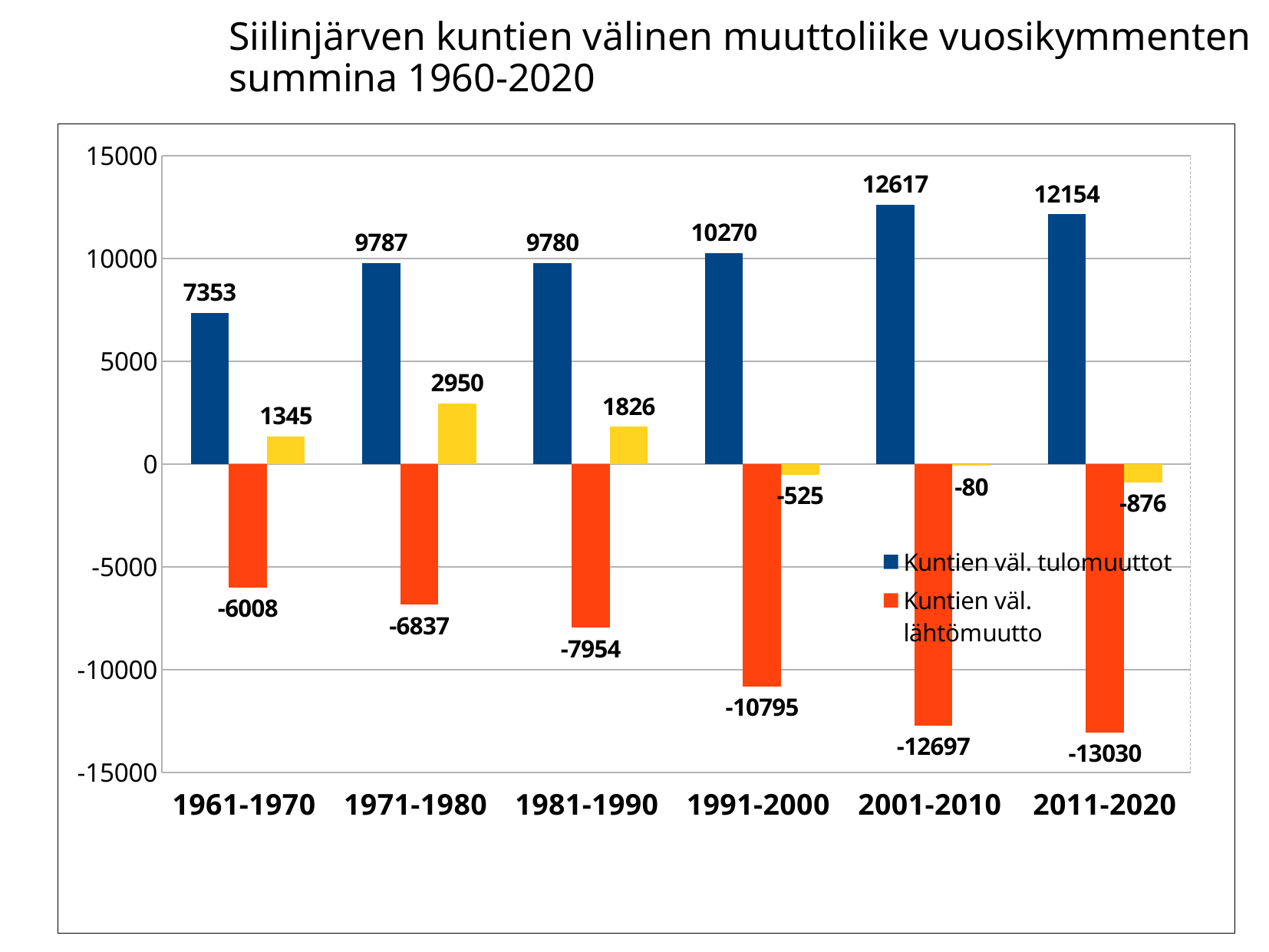
Which is larger, Kuntien väl. tulomuuttot in 2001-2010 or in 1991-2000? 2001-2010 What is the value of Kuntien väl. tulomuuttot for 1961-1970? 7353 What is the value of Kuntien väl. lähtömuutto for 2011-2020? -13030 In which period does Kuntien väl. lähtömuutto have the most negative value? 2011-2020 In which period is Kuntien väl. tulomuuttot highest? 2001-2010 In which period is Kuntien väl. tulomuuttot lowest? 1961-1970 Is the value of Kuntien väl. tulomuuttot for 1991-2000 greater or less than 10000? greater What is the difference between Kuntien väl. tulomuuttot in 1971-1980 and in 1961-1970? 2434 What kind of chart is shown on the slide? bar chart How many time periods are shown on the x axis? 6 What is the value of Kuntien väl. lähtömuutto for 1981-1990? -7954 How many series does the legend list? 2